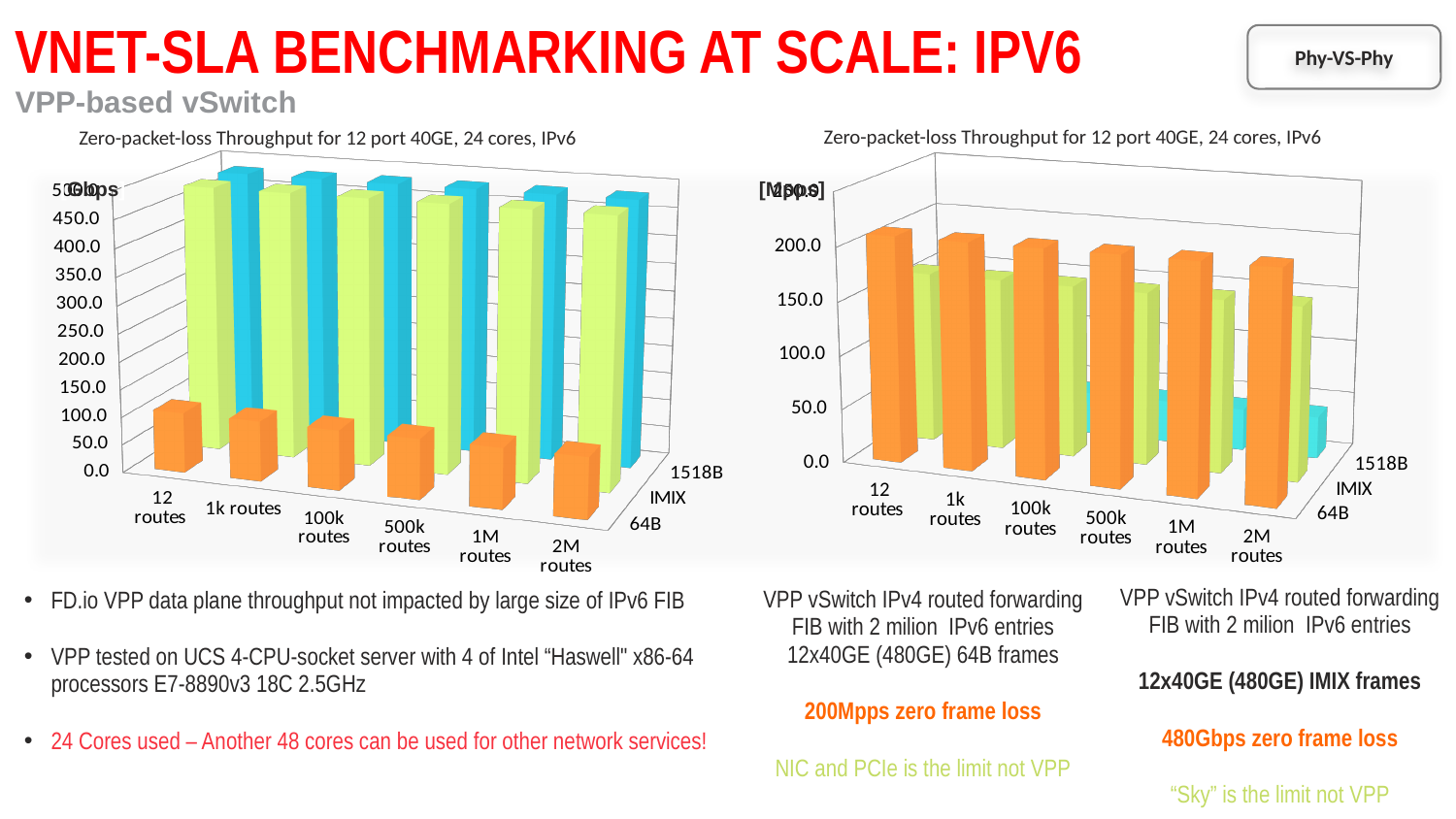
In the left chart (Gbps), which series has the lowest values across all route counts? 64B In the right chart (Mpps), is the value for 64B at 12 routes greater or less than 150? greater In the left chart (Gbps), do the 64B values rise or fall as the route count increases from 12 routes to 2M routes? Neither; they stay flat (constant) In the left chart (Gbps), is the value for 1518B at 12 routes greater or less than 400? greater In the right chart (Mpps), is the value for 1518B at 12 routes greater or less than 100? less How many series (frame sizes) does the right chart plot? 3 In the right chart (Mpps), which is larger at 12 routes: 64B or 1518B? 64B In the right chart (Mpps), which series has the highest values across all route counts? 64B What unit is shown on the vertical axis of the right chart? [Mpps] How many route-count categories are shown on the x axis of the left chart? 6 What kind of chart is the left chart on the slide? bar chart